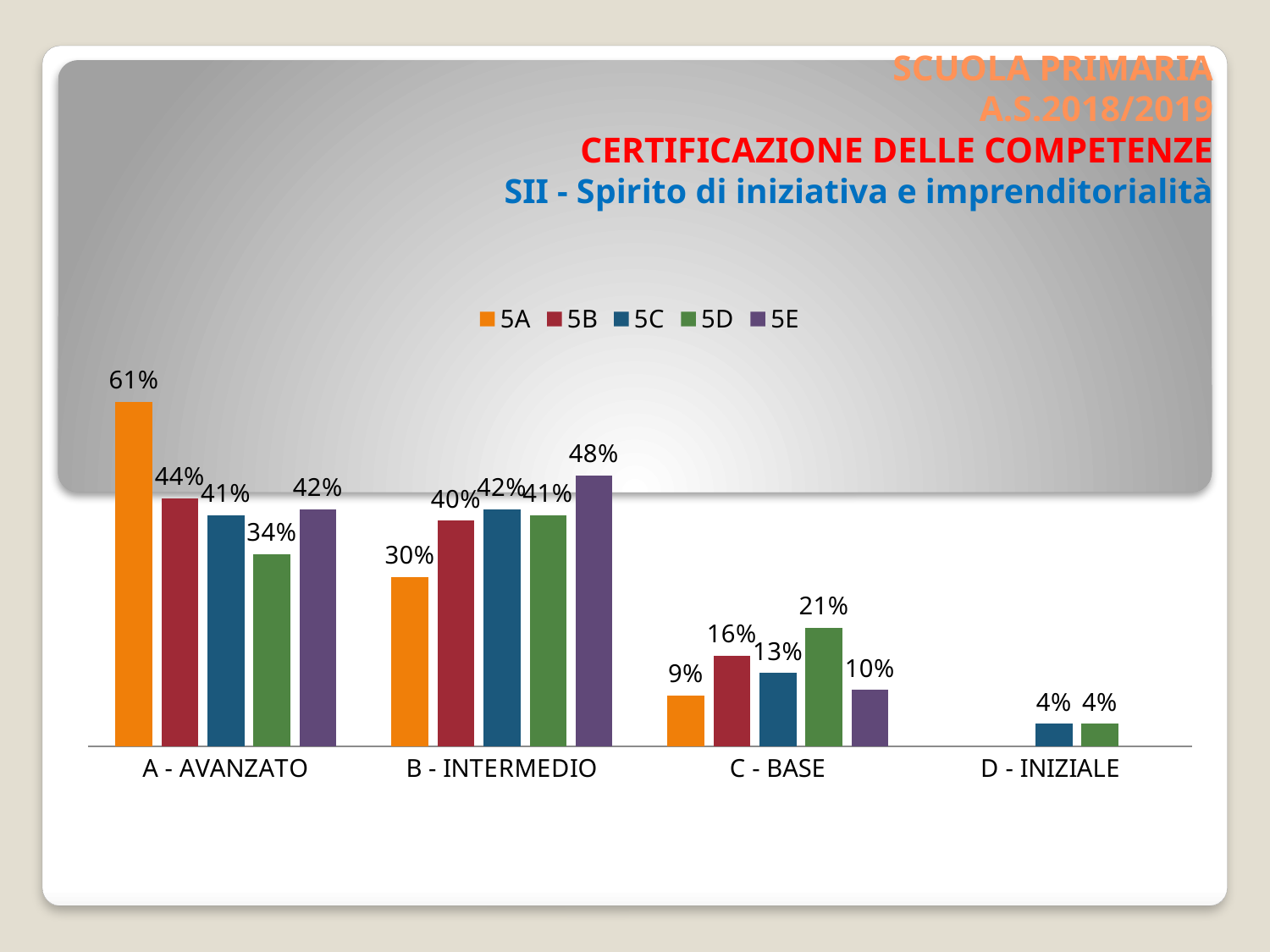
What is the value for 5A in the A - AVANZATO category? 61% Which series has the highest value in the A - AVANZATO category? 5A How many series does the legend list? 5 How many categories are shown on the x axis? 4 Which series is shown in orange in the legend? 5A What kind of chart is shown on the slide? Bar chart What is the difference between the 5A and 5D values in the A - AVANZATO category? 27% What is the value for 5E in the B - INTERMEDIO category? 48% In the C - BASE category, which is larger: the value for 5B or the value for 5C? 5B What is the value for 5D in the C - BASE category? 21% Which series has the lowest value in the B - INTERMEDIO category? 5A What is the value for 5C in the D - INIZIALE category? 4%